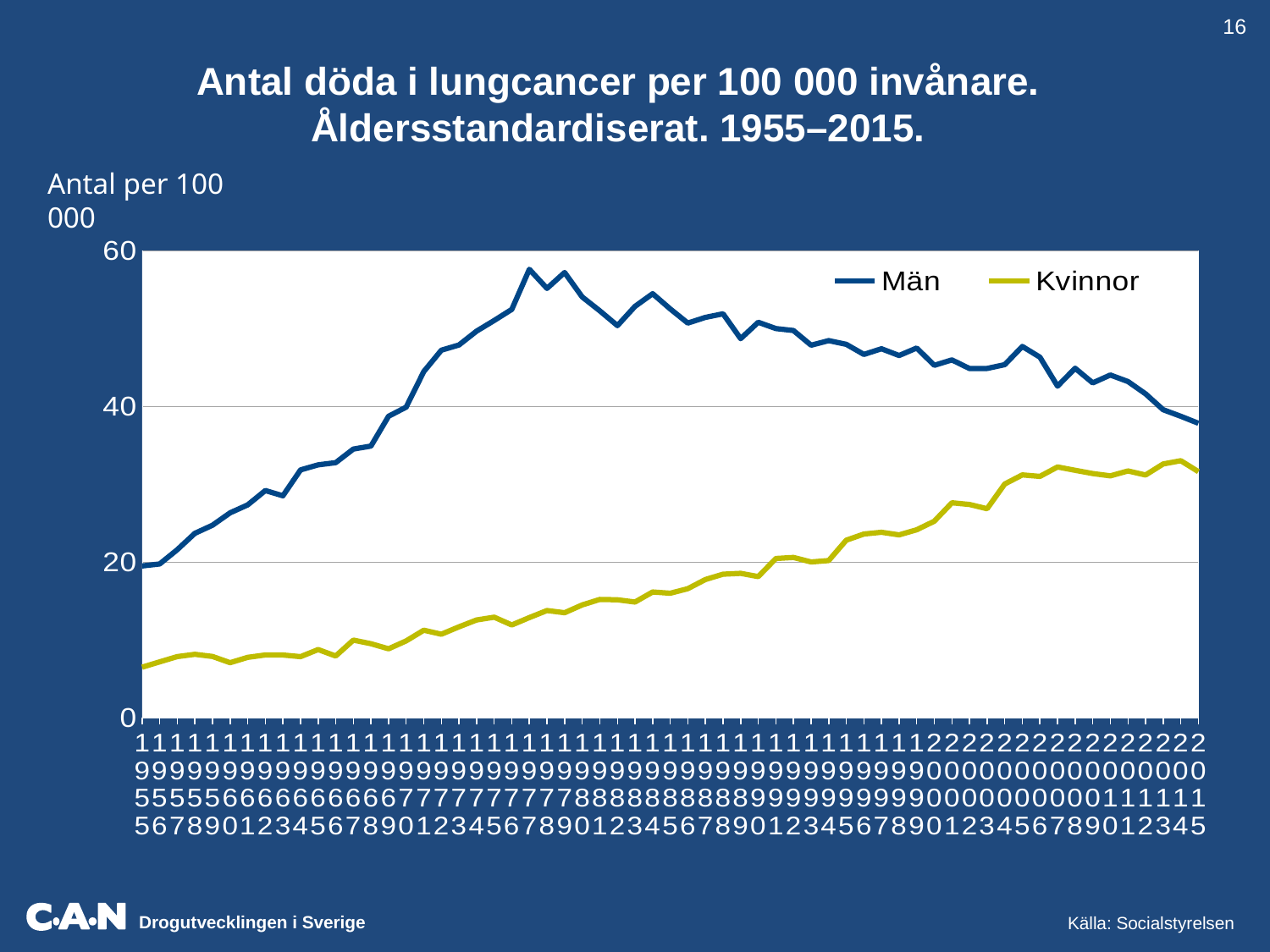
How many series does the legend list? 2 How many years (data points) does the x axis cover? 61 Is the value for Kvinnor in 1955 greater or less than 20? less Is the value for Män in 1960 greater or less than 40? less What are the two series named in the legend? Män and Kvinnor What is the label shown on the vertical axis? Antal per 100 000 Does the Kvinnor line generally rise or fall from 1955 to 2015? rise Does the Män line rise or fall between 1980 and 2015? fall Which series has the higher value in 1990, Män or Kvinnor? Män What kind of chart is shown on the slide? line chart Is the value for Män in 1980 greater or less than 40? greater